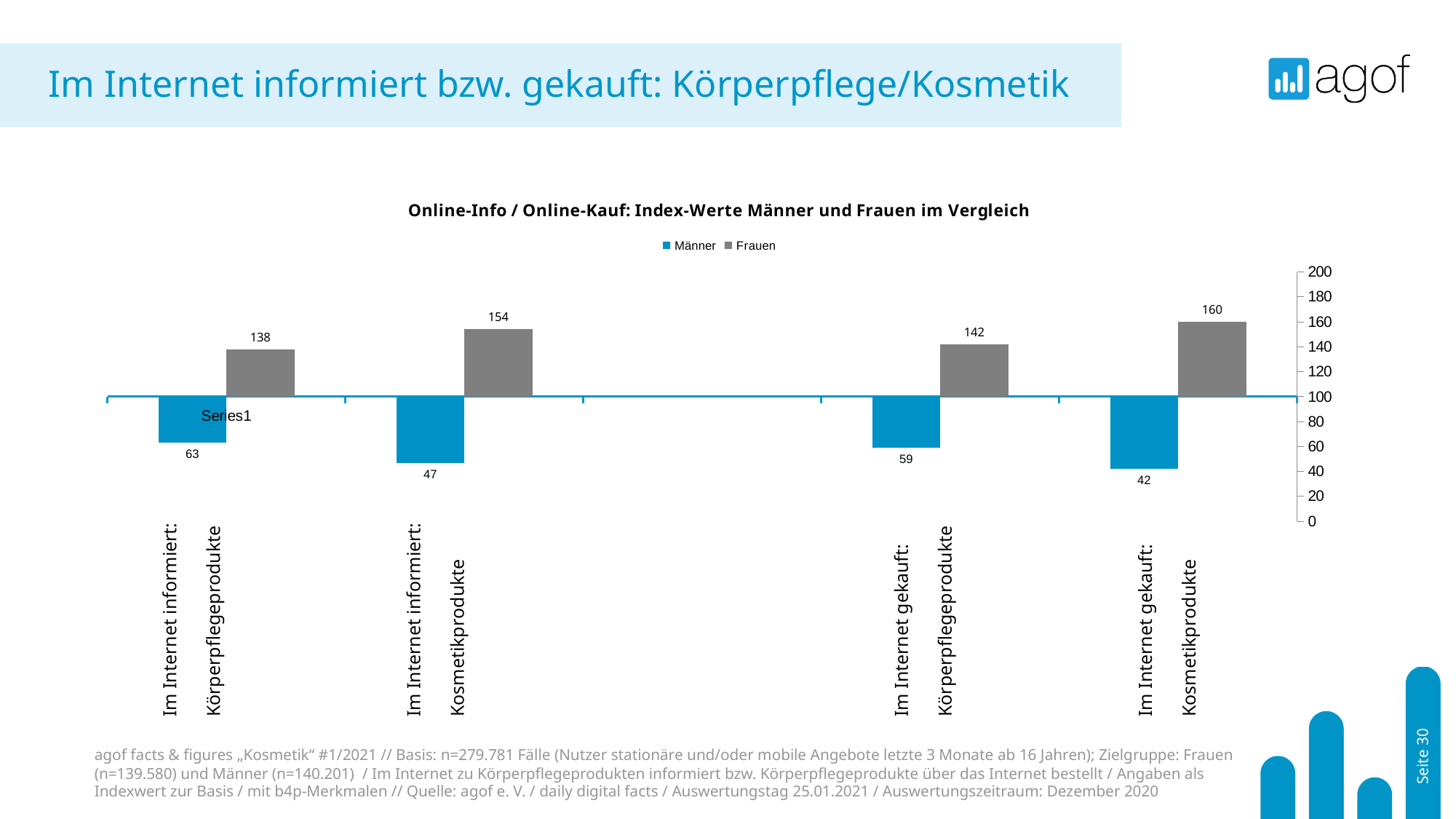
What is the difference between the Frauen and Männer index values for "Im Internet informiert: Kosmetikprodukte"? 107 What kind of chart is shown on the slide? Bar chart What is the Frauen index value for "Im Internet gekauft: Kosmetikprodukte"? 160 What is the Männer index value for "Im Internet gekauft: Körperpflegeprodukte"? 59 What is the title of the chart? Online-Info / Online-Kauf: Index-Werte Männer und Frauen im Vergleich Which is larger: the Frauen value for "Im Internet informiert: Körperpflegeprodukte" or the Frauen value for "Im Internet gekauft: Körperpflegeprodukte"? Im Internet gekauft: Körperpflegeprodukte What is the Frauen index value for "Im Internet informiert: Kosmetikprodukte"? 154 Which category has the lowest Männer index value? Im Internet gekauft: Kosmetikprodukte How many series does the legend list? 2 What is the Männer index value for "Im Internet informiert: Körperpflegeprodukte"? 63 Which category has the highest Frauen index value? Im Internet gekauft: Kosmetikprodukte How many categories are shown on the x axis of the chart? 4